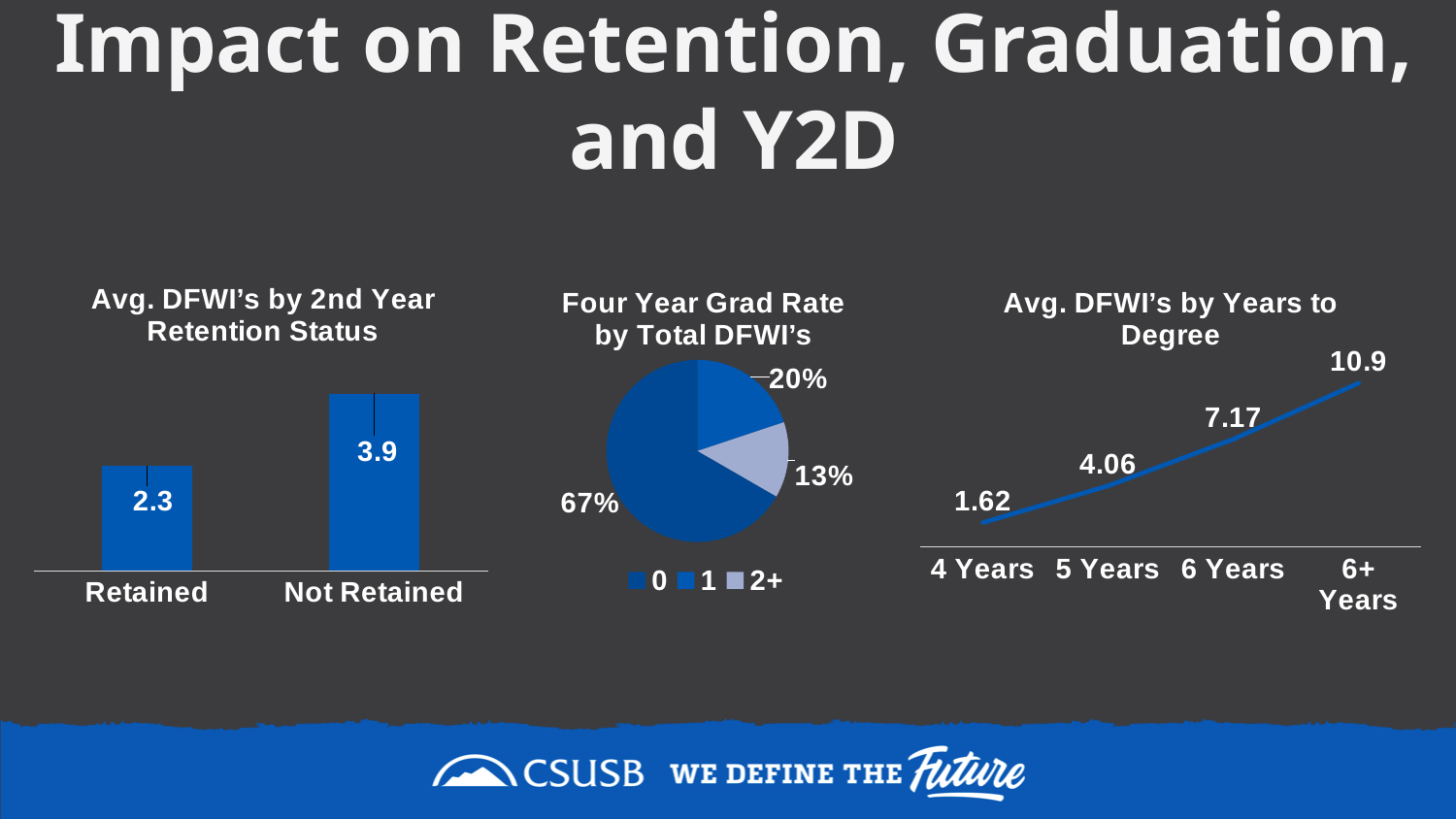
In the 'Avg. DFWI's by 2nd Year Retention Status' chart, what is the value for Retained? 2.3 In the 'Avg. DFWI's by Years to Degree' chart, what is the value for 6+ Years? 10.9 In the 'Four Year Grad Rate by Total DFWI's' pie chart, which slice is the largest? 0 How many categories are shown on the x axis of the 'Avg. DFWI's by Years to Degree' chart? 4 In the 'Avg. DFWI's by 2nd Year Retention Status' chart, what is the value for Not Retained? 3.9 What kind of chart is 'Avg. DFWI's by 2nd Year Retention Status'? bar chart In the 'Avg. DFWI's by Years to Degree' chart, do the values rise or fall from 4 Years to 6+ Years? rise In the 'Avg. DFWI's by Years to Degree' chart, what is the value for 5 Years? 4.06 How many entries does the legend of the 'Four Year Grad Rate by Total DFWI's' chart list? 3 In the 'Four Year Grad Rate by Total DFWI's' pie chart, what share does the '0' slice have? 67% In the 'Avg. DFWI's by 2nd Year Retention Status' chart, what is the difference between Not Retained and Retained? 1.6 In the 'Four Year Grad Rate by Total DFWI's' pie chart, what share does the '2+' slice have? 13%